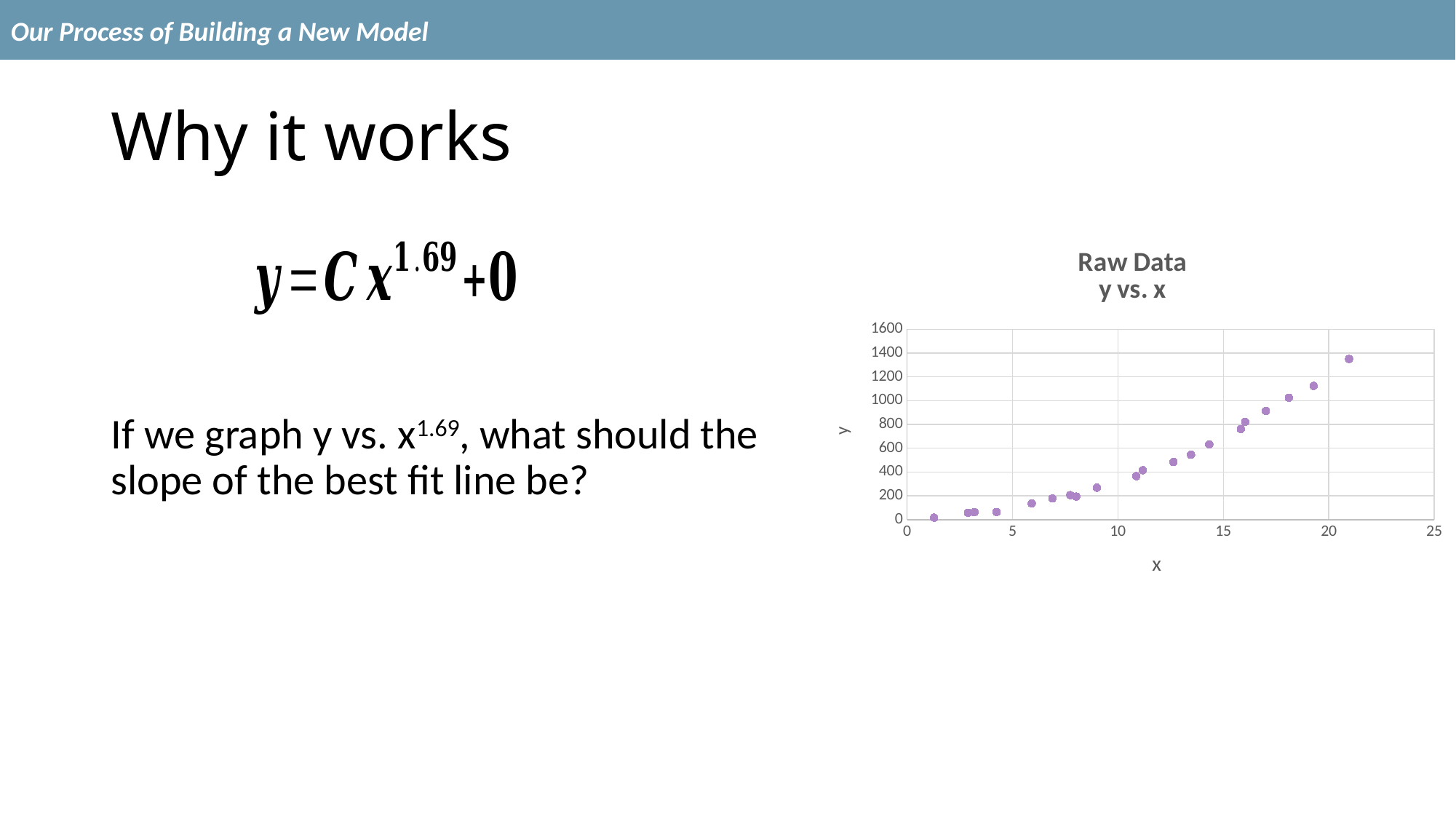
What is the highest value shown on the y axis? 1600 What is the label of the horizontal axis of the chart? x Do the y values rise or fall as x increases along the x axis? rise Is the y value of the point near x = 19 greater or less than 1000? greater Is the y value of the point near x = 9 greater or less than 200? greater Is the y value of the rightmost point (near x = 21) greater or less than 1200? greater What is the title of the chart? Raw Data y vs. x What kind of chart is shown on the slide? scatter plot Which point has the highest y value: the one near x = 21 or the one near x = 11? the one near x = 21